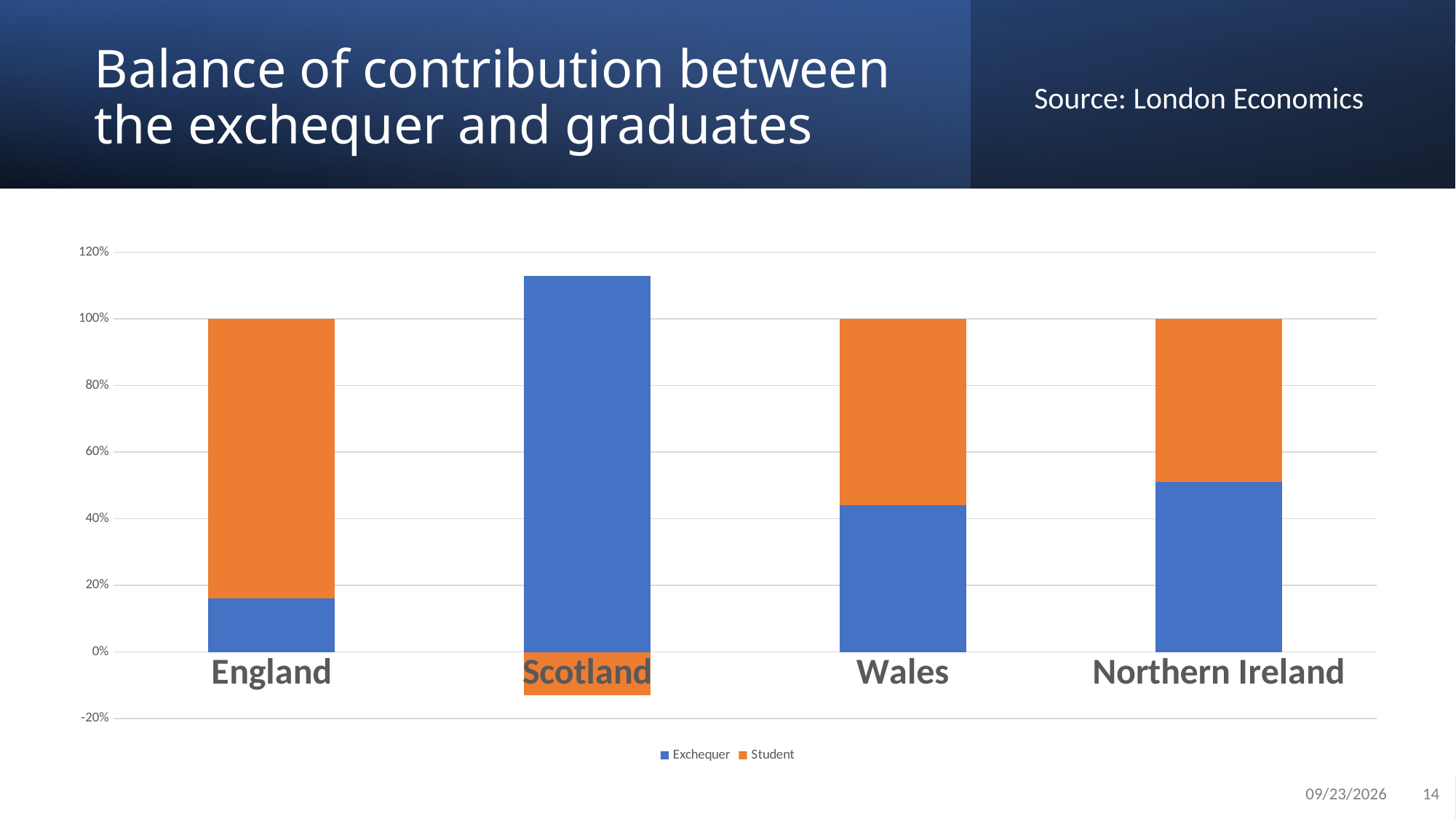
Is the Student value for Scotland greater or less than 0%? less Which nation has the highest Student value? England How many series does the legend list? 2 Which nation has the highest Exchequer value? Scotland What source is cited for the chart? London Economics Is the Exchequer value for Wales greater or less than 40%? greater Which nation has the lowest Exchequer value? England What kind of chart is shown on the slide? bar chart How many categories (nations) are shown on the x axis? 4 Which has the larger Exchequer value, Wales or Northern Ireland? Northern Ireland Is the Exchequer value for Scotland greater or less than 100%? greater